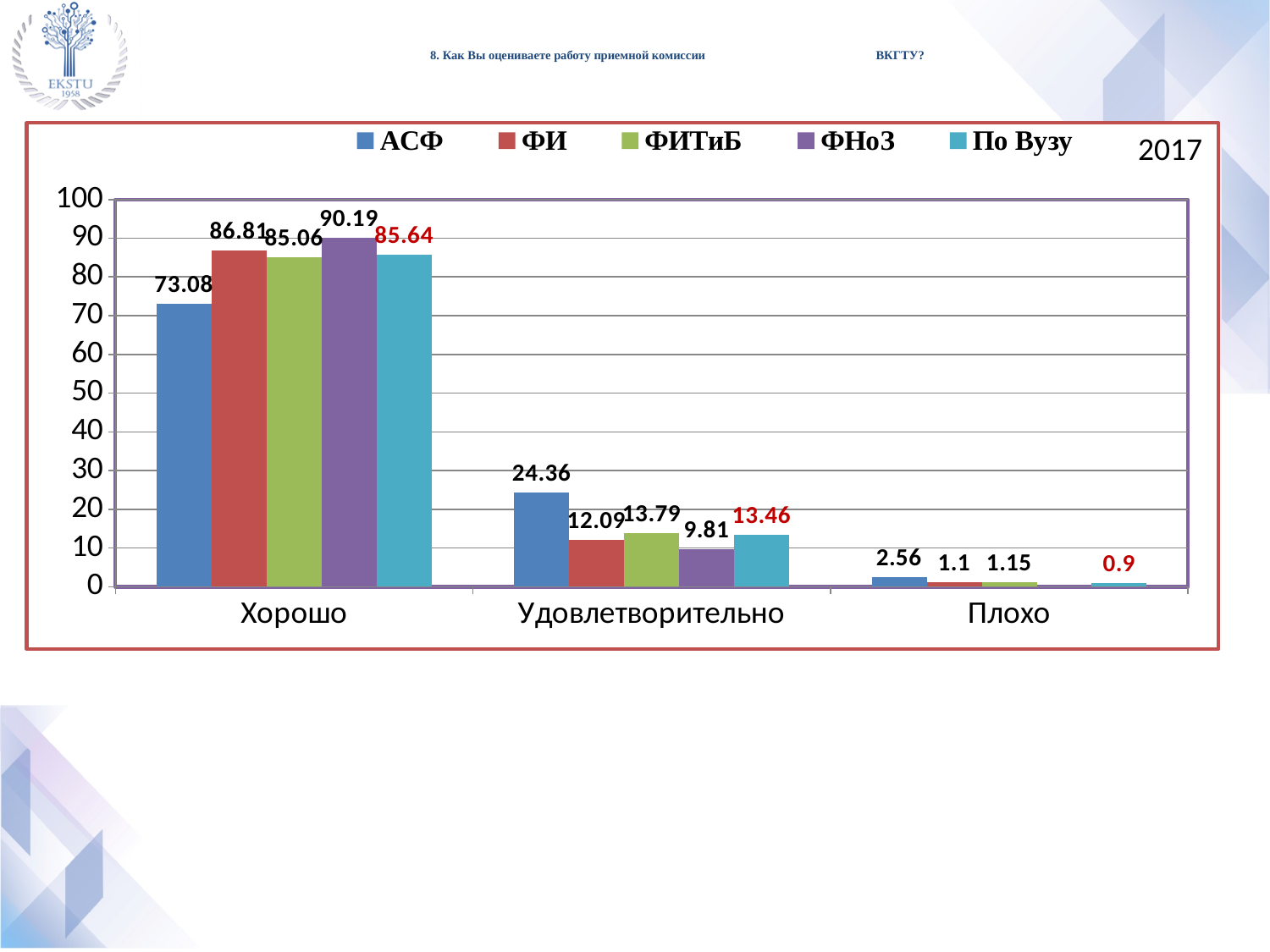
What is the value for По Вузу in the Плохо category? 0.9 What is the value for ФНоЗ in the Хорошо category? 90.19 How many categories are shown on the x axis? 3 Is the value for АСФ in the Хорошо category greater or less than 80? less How many series does the legend list? 5 Which series has the lowest value in the Удовлетворительно category? ФНоЗ Which is larger in the Удовлетворительно category: ФИТиБ or ФИ? ФИТиБ Which series has the highest value in the Хорошо category? ФНоЗ What kind of chart is shown on the slide? bar chart What is the difference between the ФИ and АСФ values in the Хорошо category? 13.73 What year is shown in the top right corner of the chart? 2017 What is the value for АСФ in the Удовлетворительно category? 24.36